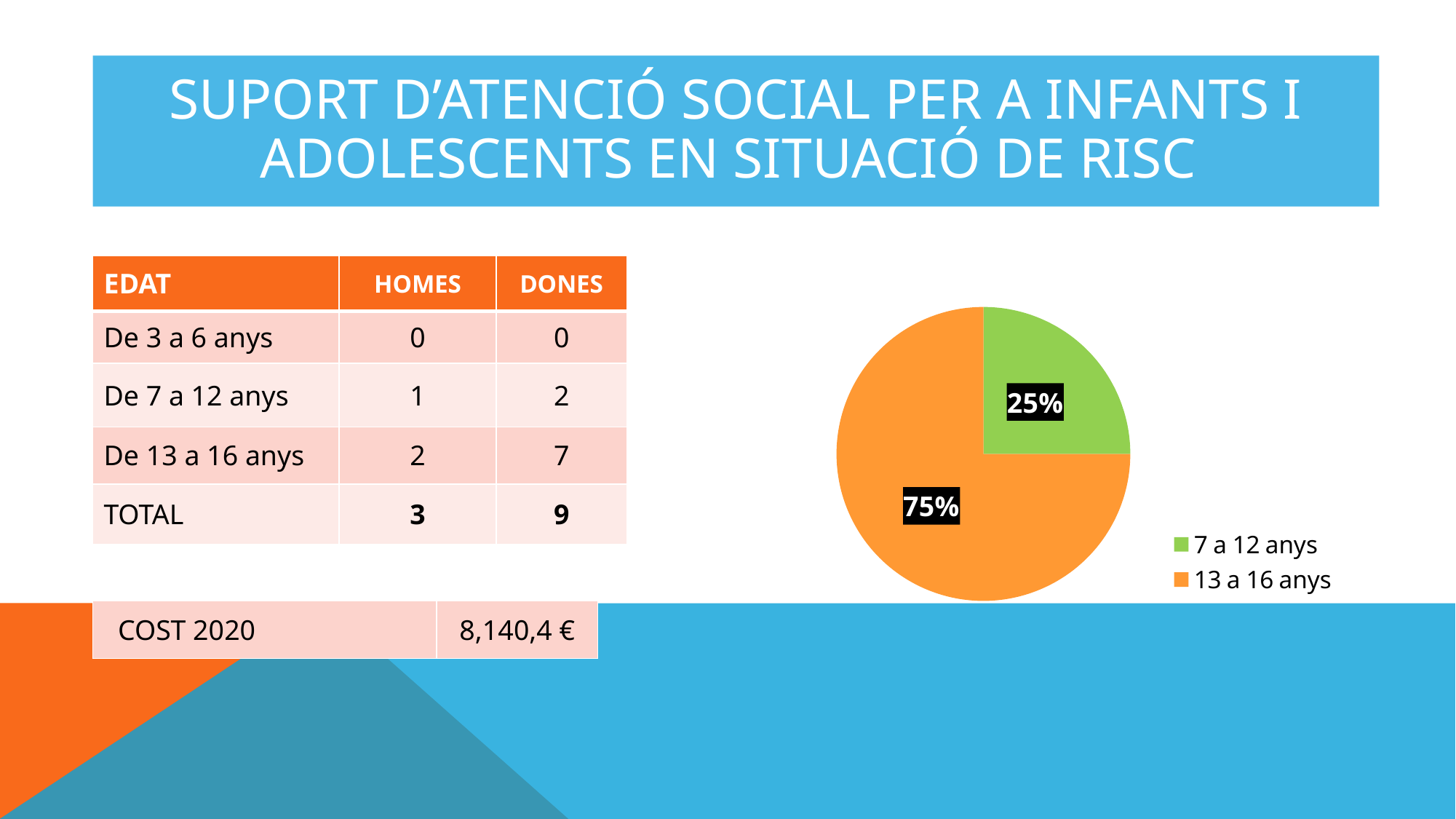
Which is larger in the pie chart: the "7 a 12 anys" slice or the "13 a 16 anys" slice? 13 a 16 anys How many entries does the pie chart's legend list? 2 What colour is the "7 a 12 anys" slice in the pie chart? green Is the share of the "13 a 16 anys" slice greater or less than 50%? greater What share of the pie does the "13 a 16 anys" slice represent? 75% What colour is the "13 a 16 anys" slice in the pie chart? orange What kind of chart is shown on the slide? pie chart What share of the pie does the "7 a 12 anys" slice represent? 25% Which slice of the pie chart is the smallest? 7 a 12 anys What is the difference in percentage points between the "13 a 16 anys" slice and the "7 a 12 anys" slice? 50 percentage points How many slices does the pie chart have? 2 Which slice of the pie chart is the largest? 13 a 16 anys